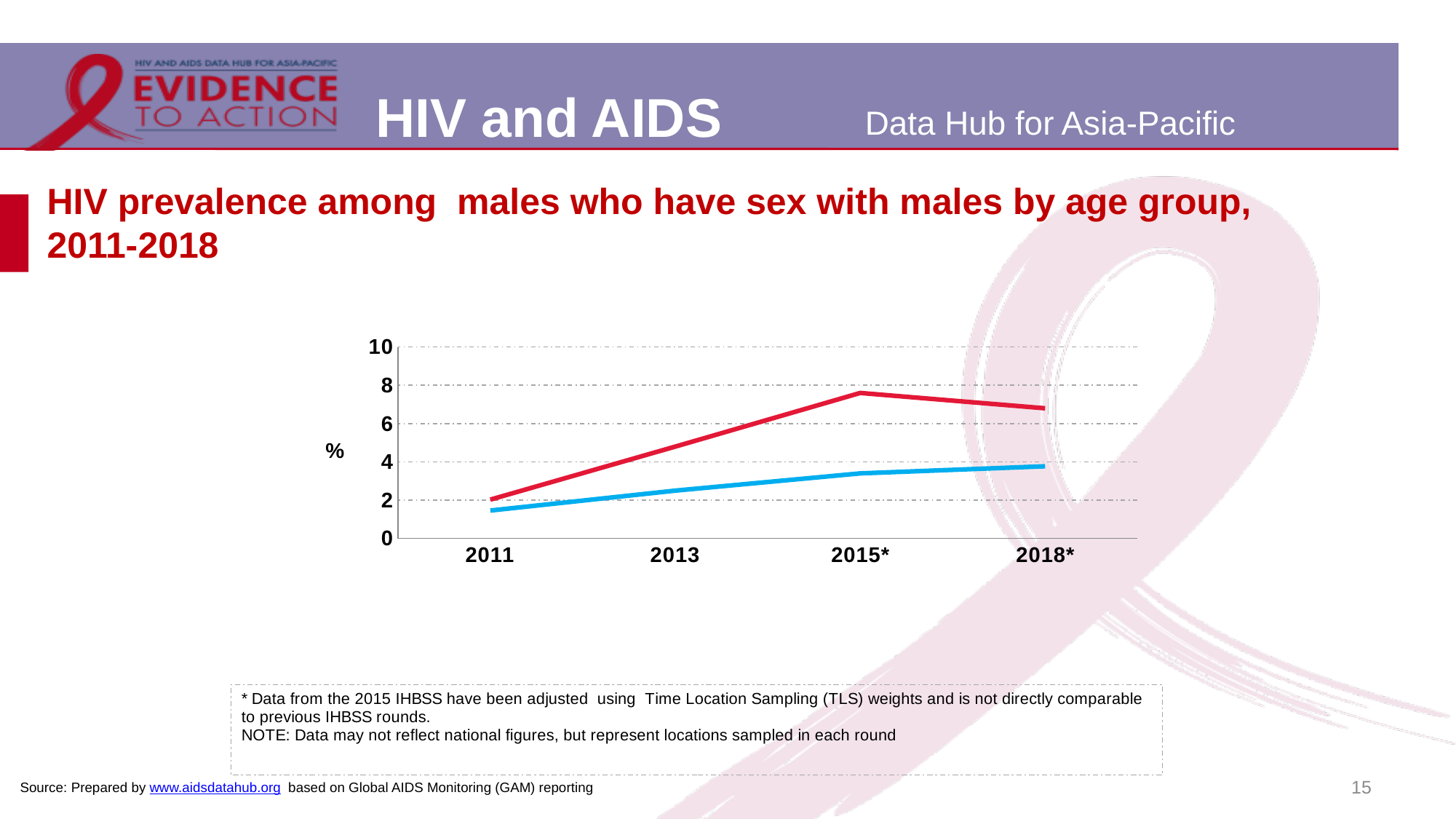
Is the value of the red line in 2013 greater or less than 4? greater In which year does the red line reach its highest value? 2015* Does the blue line rise or fall from 2011 to 2018*? rise In which year is the red line at its lowest value? 2011 Is the value of the red line in 2015* greater or less than 6? greater Is the value of the red line in 2018* greater or less than 8? less What kind of chart is shown on the slide? line chart In 2015*, which line has the higher value, the red line or the blue line? the red line In which year is the blue line at its lowest value? 2011 What is the label on the y axis of the chart? % How many years are plotted along the x axis of the chart? 4